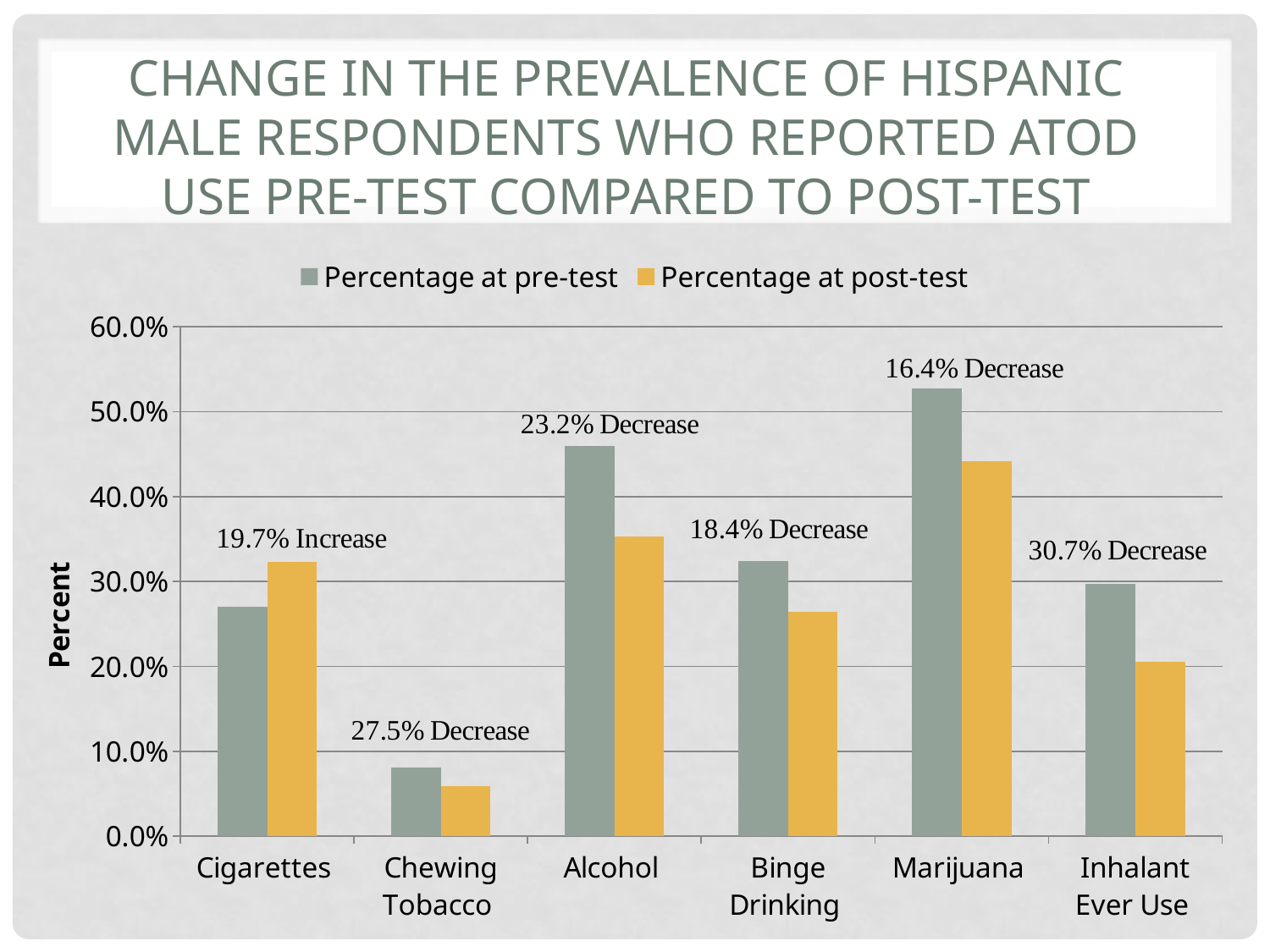
Which category has the highest pre-test percentage? Marijuana Is the post-test percentage for Alcohol greater or less than 40.0%? less Is the pre-test percentage for Marijuana greater or less than 50.0%? greater Which category has the lowest post-test percentage? Chewing Tobacco What change is annotated above the Alcohol bars? 23.2% Decrease For Alcohol, which is larger: the percentage at pre-test or the percentage at post-test? Percentage at pre-test For Cigarettes, which is larger: the percentage at pre-test or the percentage at post-test? Percentage at post-test What kind of chart is shown on the slide? bar chart Is the pre-test percentage for Chewing Tobacco greater or less than 10.0%? less What change is annotated above the Cigarettes bars? 19.7% Increase How many series does the legend list? 2 How many substance categories are shown on the x axis? 6